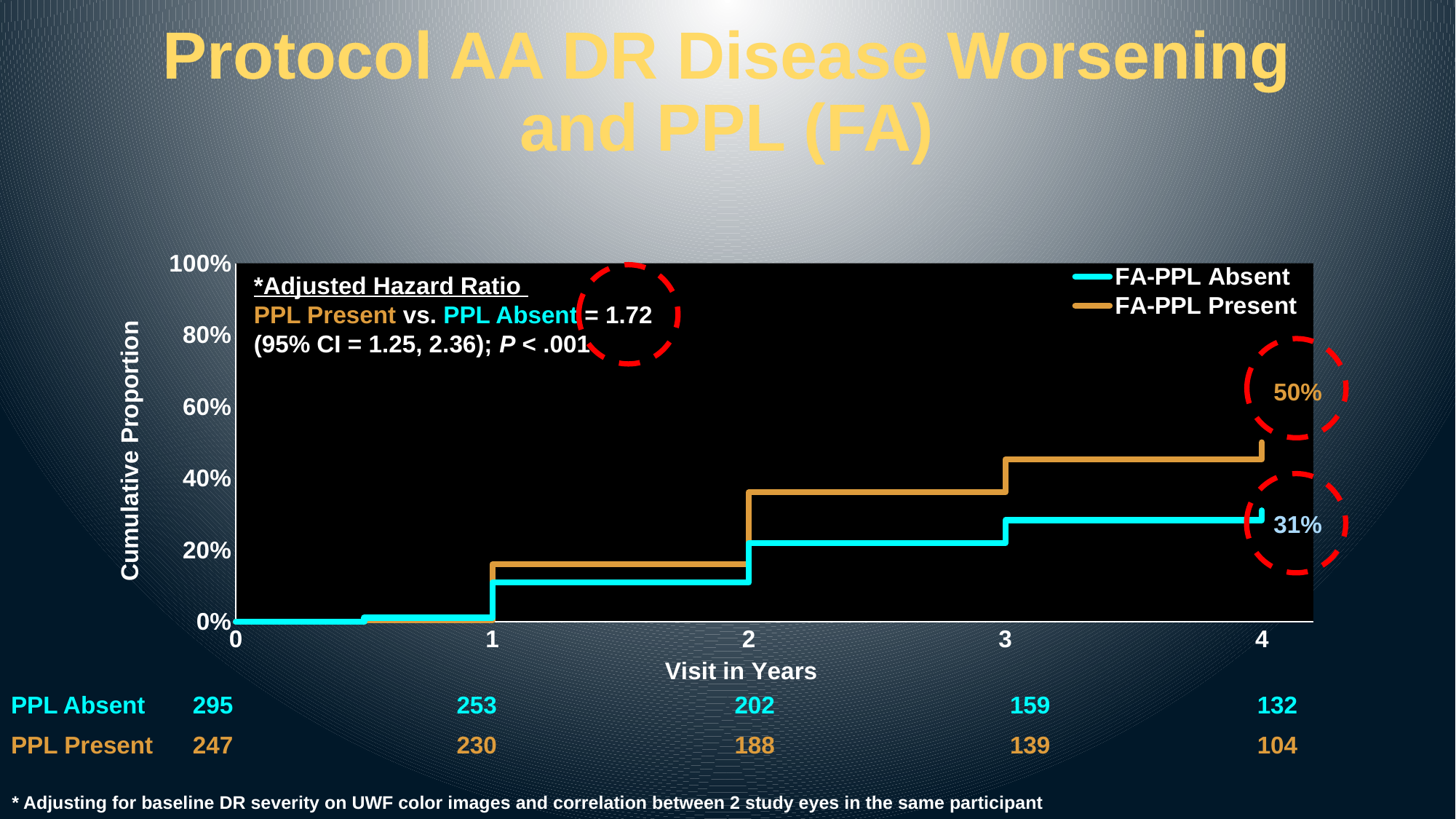
What is the difference between the year-4 cumulative proportions of FA-PPL Present and FA-PPL Absent? 19% What is the cumulative proportion for FA-PPL Absent at year 4? 31% Is the value for FA-PPL Absent at year 3 greater or less than 40%? less What is the adjusted hazard ratio for PPL Present vs. PPL Absent shown on the chart? 1.72 Do the cumulative proportions rise or fall as visit years increase? rise How many visit-year tick marks are shown on the x axis? 5 Is the value for FA-PPL Present at year 3 greater or less than 40%? greater How many series does the legend list? 2 What is the cumulative proportion for FA-PPL Present at year 4? 50% What is the label of the y axis? Cumulative Proportion What kind of chart is shown on the slide? line chart Which series has the higher cumulative proportion at year 4, FA-PPL Present or FA-PPL Absent? FA-PPL Present